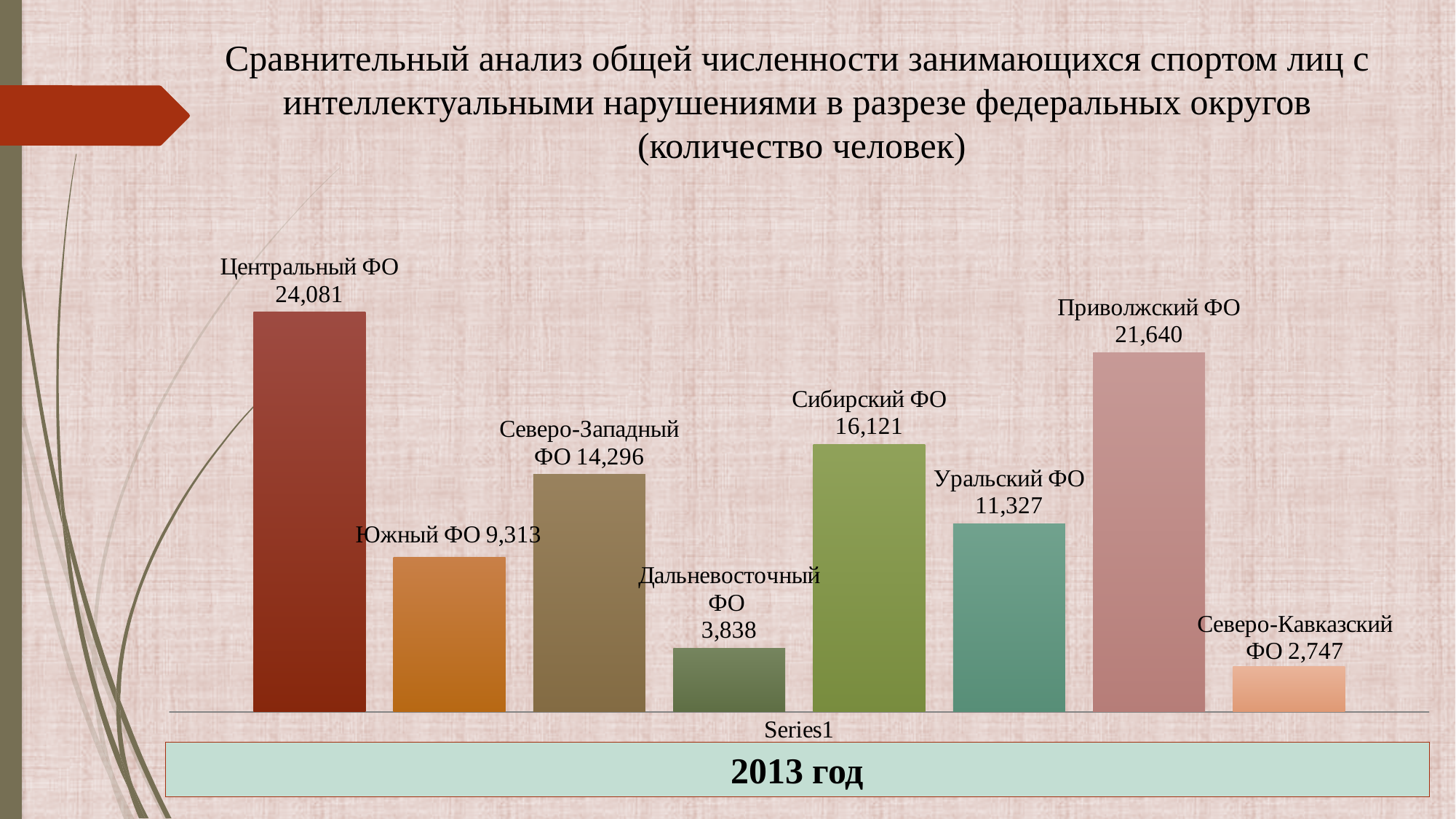
Which federal district has the lowest value? Северо-Кавказский ФО What is the value for Центральный ФО? 24,081 What is the difference between the values for Центральный ФО and Приволжский ФО? 2,441 What is the value for Приволжский ФО? 21,640 What year is indicated below the chart? 2013 год What is the value for Дальневосточный ФО? 3,838 What is the value for Уральский ФО? 11,327 How many federal districts are shown in the chart? 8 What type of chart is shown on the slide? bar chart What is the difference between the values for Южный ФО and Северо-Кавказский ФО? 6,566 Which has a larger value, Сибирский ФО or Северо-Западный ФО? Сибирский ФО Which federal district has the highest value? Центральный ФО